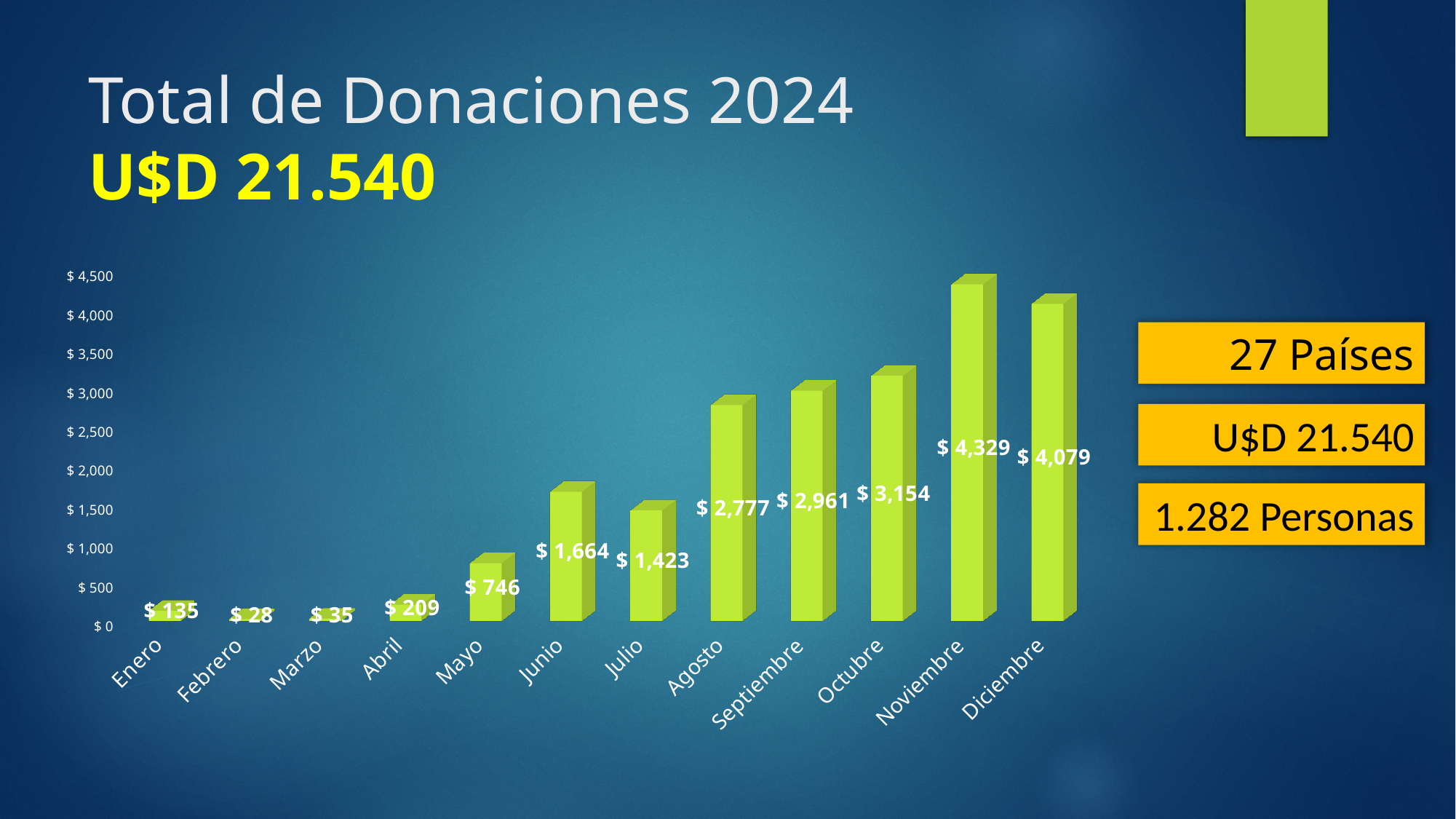
Is the value for Octubre greater or less than $ 3,000? greater What is the value for Noviembre? $ 4,329 Which month has the lowest value? Febrero What is the difference between the values for Noviembre and Diciembre? $ 250 What is the title shown above the chart? Total de Donaciones 2024 Which is larger, the value for Agosto or the value for Septiembre? Septiembre How many months are shown on the x axis? 12 What is the value for Mayo? $ 746 Which month has the highest value? Noviembre What is the value for Febrero? $ 28 What kind of chart is shown on the slide? bar chart What is the difference between the values for Junio and Julio? $ 241